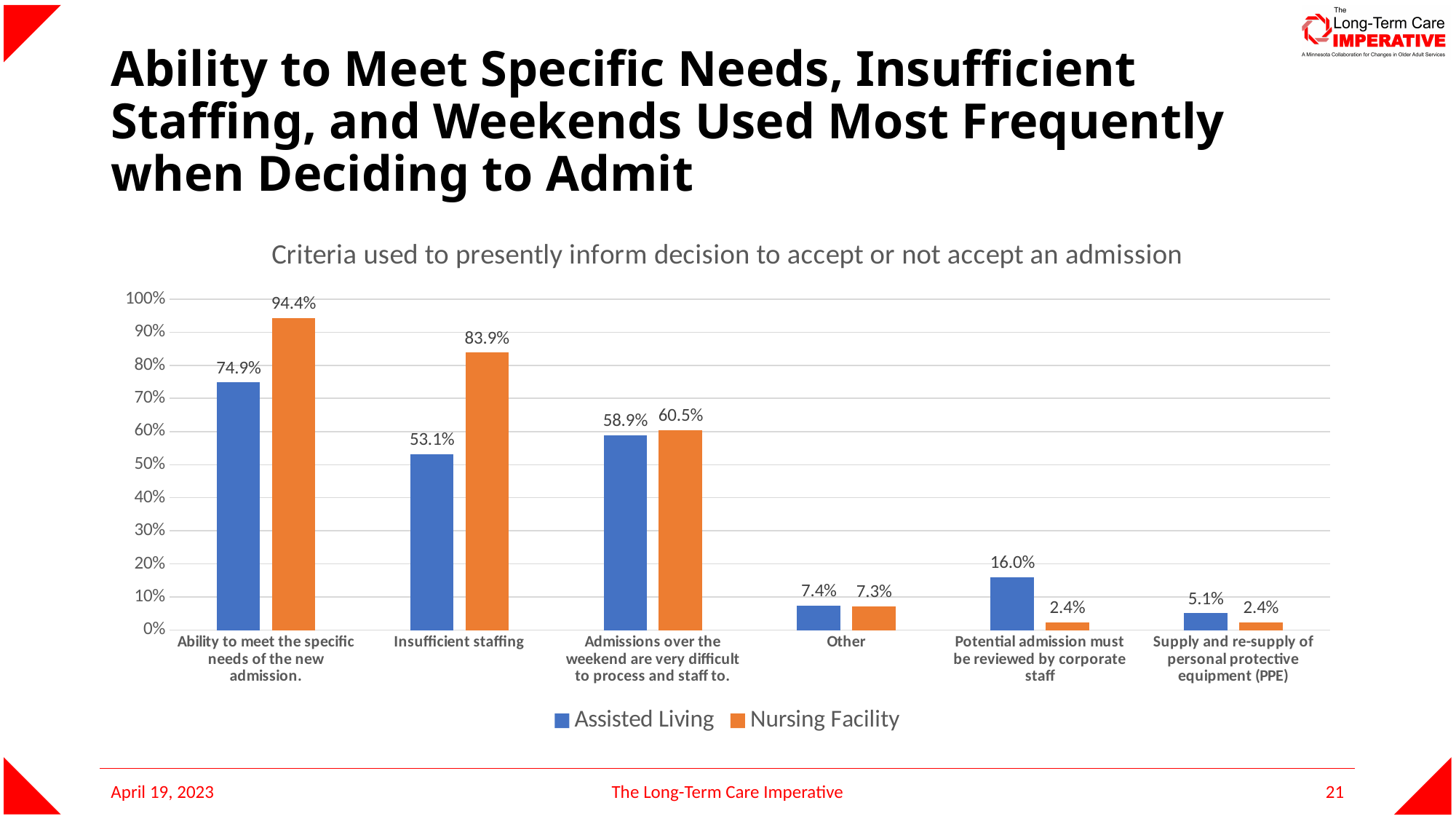
Which category has the lowest Assisted Living value? Supply and re-supply of personal protective equipment (PPE) What is the Nursing Facility value for "Potential admission must be reviewed by corporate staff"? 2.4% How many categories are shown on the x axis? 6 Which category has the highest Assisted Living value? Ability to meet the specific needs of the new admission. What is the Assisted Living value for "Insufficient staffing"? 53.1% Is the Assisted Living value for "Admissions over the weekend are very difficult to process and staff to." greater or less than 50%? greater For "Potential admission must be reviewed by corporate staff", which series has the larger value, Assisted Living or Nursing Facility? Assisted Living What is the title of the chart? Criteria used to presently inform decision to accept or not accept an admission What kind of chart is shown on the slide? Bar chart What is the Nursing Facility value for "Ability to meet the specific needs of the new admission."? 94.4% What is the difference between the Nursing Facility and Assisted Living values for "Insufficient staffing"? 30.8% How many series does the legend list? 2